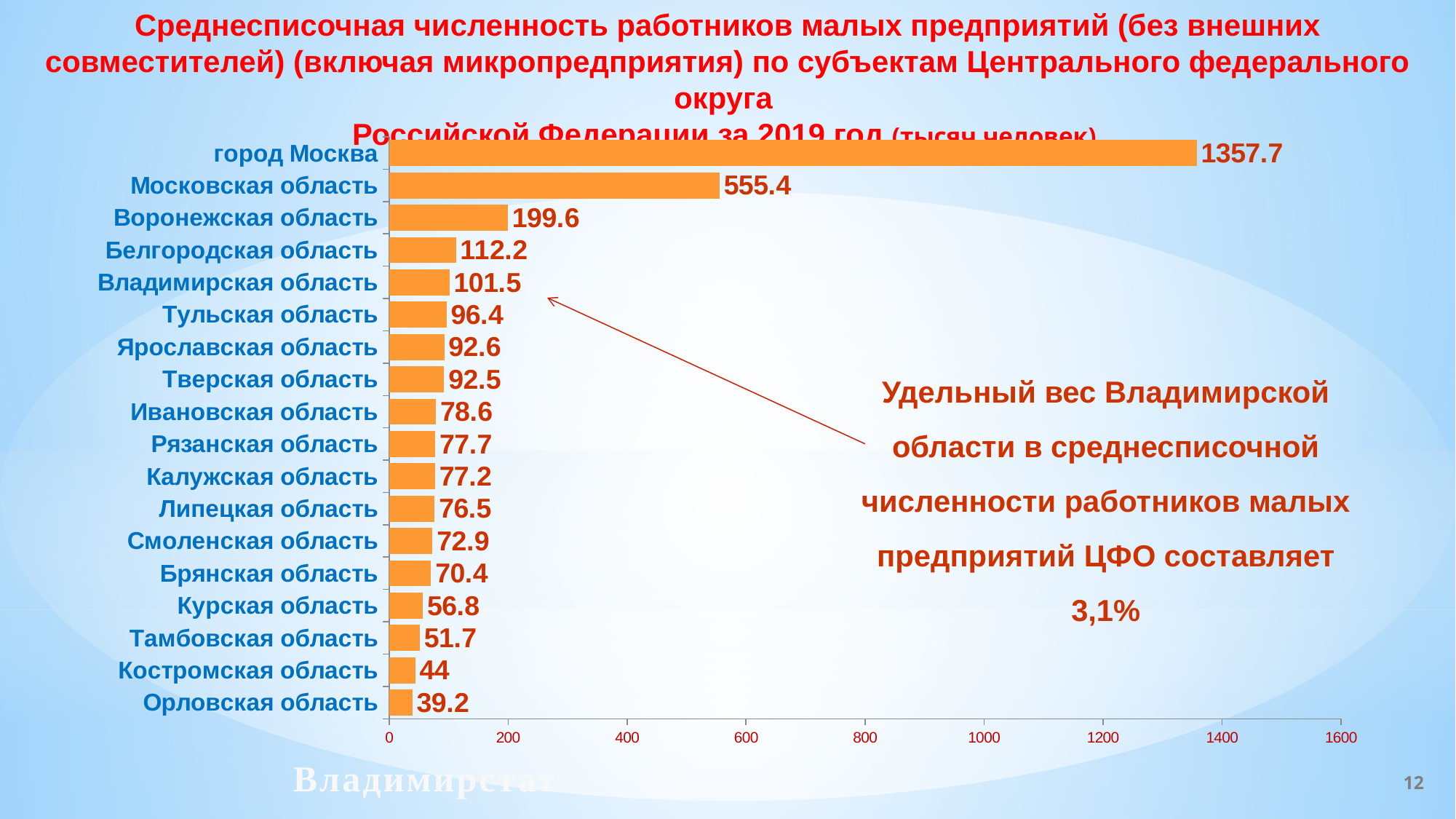
What is the value for Костромская область? 44 What is the difference between the values for Воронежская область and Белгородская область? 87.4 Do the values increase or decrease going from the top bar to the bottom bar? decrease Which is larger, the value for Тульская область or Ивановская область? Тульская область What is the value for Владимирская область? 101.5 Which region has the lowest value? Орловская область Which region has the highest value? город Москва What type of chart is shown on the slide? bar chart Is the value for Московская область greater or less than 400? greater What is the value for город Москва? 1357.7 How many regions are shown in the chart? 18 What is the difference between the values for город Москва and Московская область? 802.3